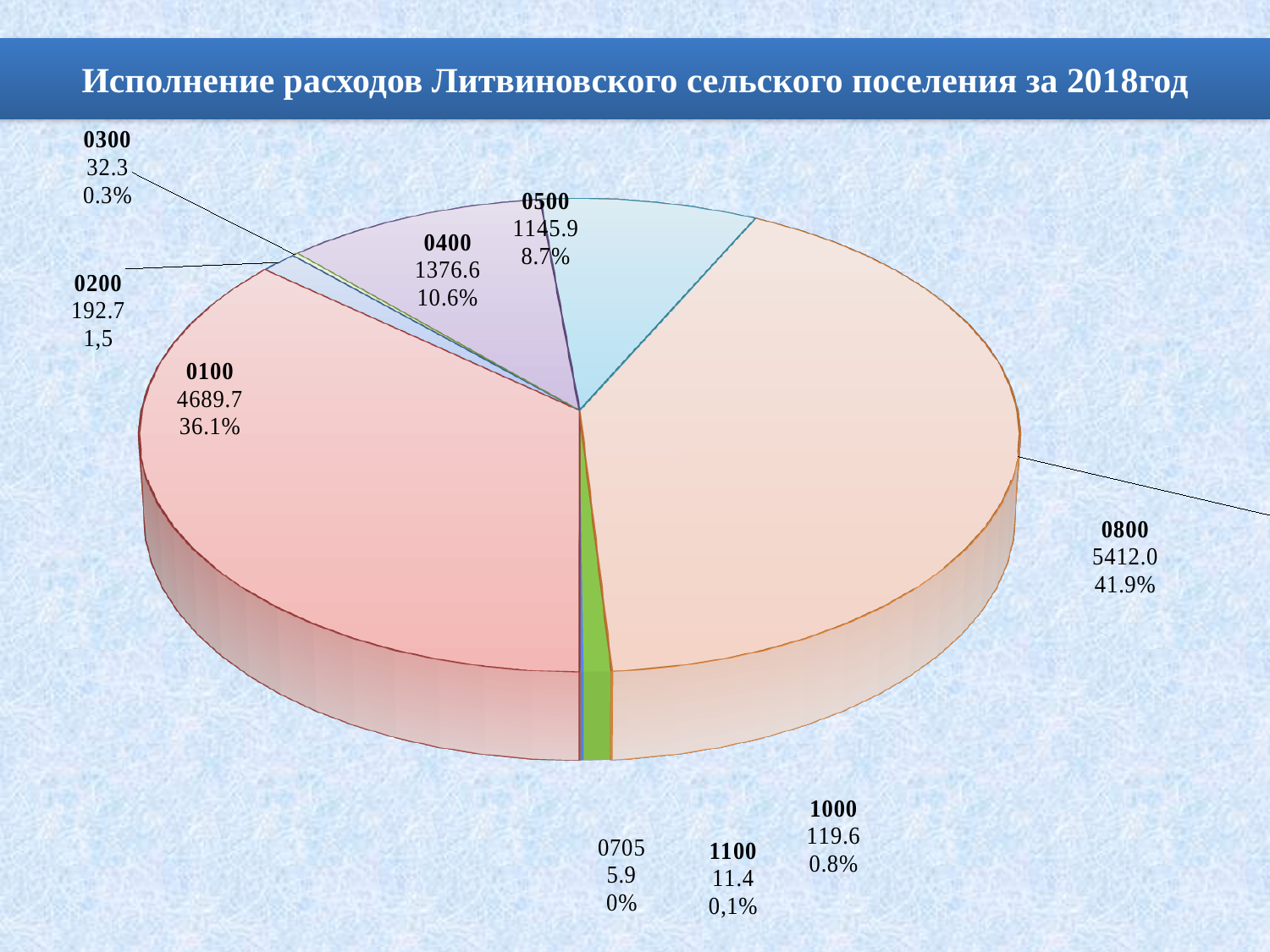
What is the value shown for category 1000? 119.6 What percentage share is shown for category 0500? 8.7% Which category has the smallest value in the pie chart? 0705 How many categories are shown in the pie chart? 9 What percentage share is shown for category 0100? 36.1% What is the value shown for category 0800? 5412.0 What is the difference between the values for 0800 and 0100? 722.3 What kind of chart is shown on the slide? pie chart Which is larger, the value for 0400 or the value for 0500? 0400 What is the title of the chart on the slide? Исполнение расходов Литвиновского сельского поселения за 2018год Which category has the largest slice of the pie? 0800 What is the value shown for category 0400? 1376.6